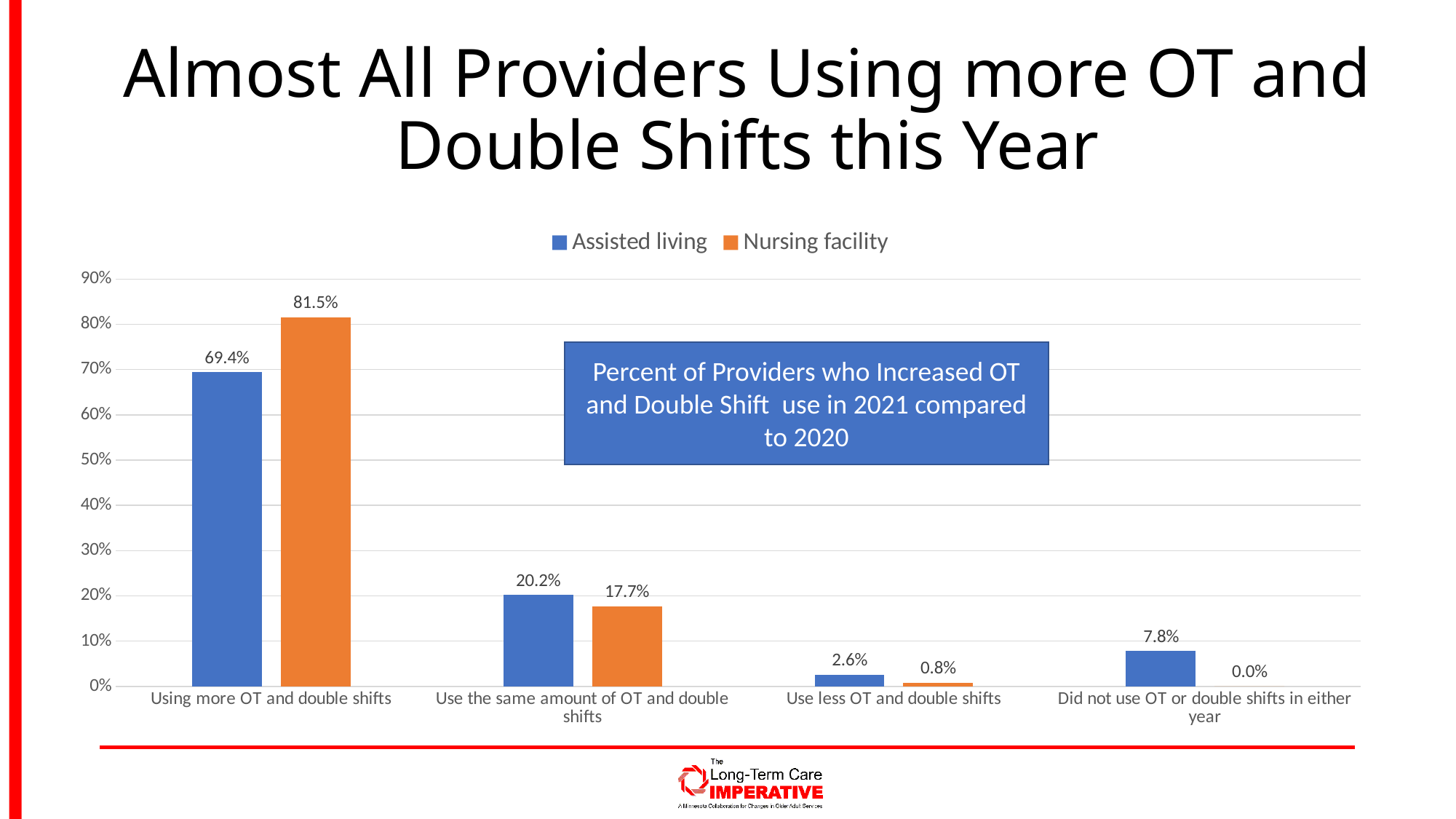
Which colour represents the Nursing facility series? Orange Which category has the highest value for Nursing facility? Using more OT and double shifts How many categories are shown on the x axis? 4 What is the value for Nursing facility in the 'Use the same amount of OT and double shifts' category? 17.7% In the 'Use less OT and double shifts' category, which series has the larger value, Assisted living or Nursing facility? Assisted living What is the value for Nursing facility in the 'Using more OT and double shifts' category? 81.5% How many series does the legend list? 2 What is the value for Assisted living in the 'Did not use OT or double shifts in either year' category? 7.8% What is the value for Assisted living in the 'Using more OT and double shifts' category? 69.4% What is the difference between the Nursing facility and Assisted living values in the 'Using more OT and double shifts' category? 12.1% What kind of chart is shown on the slide? Bar chart Which category has the lowest value for Nursing facility? Did not use OT or double shifts in either year